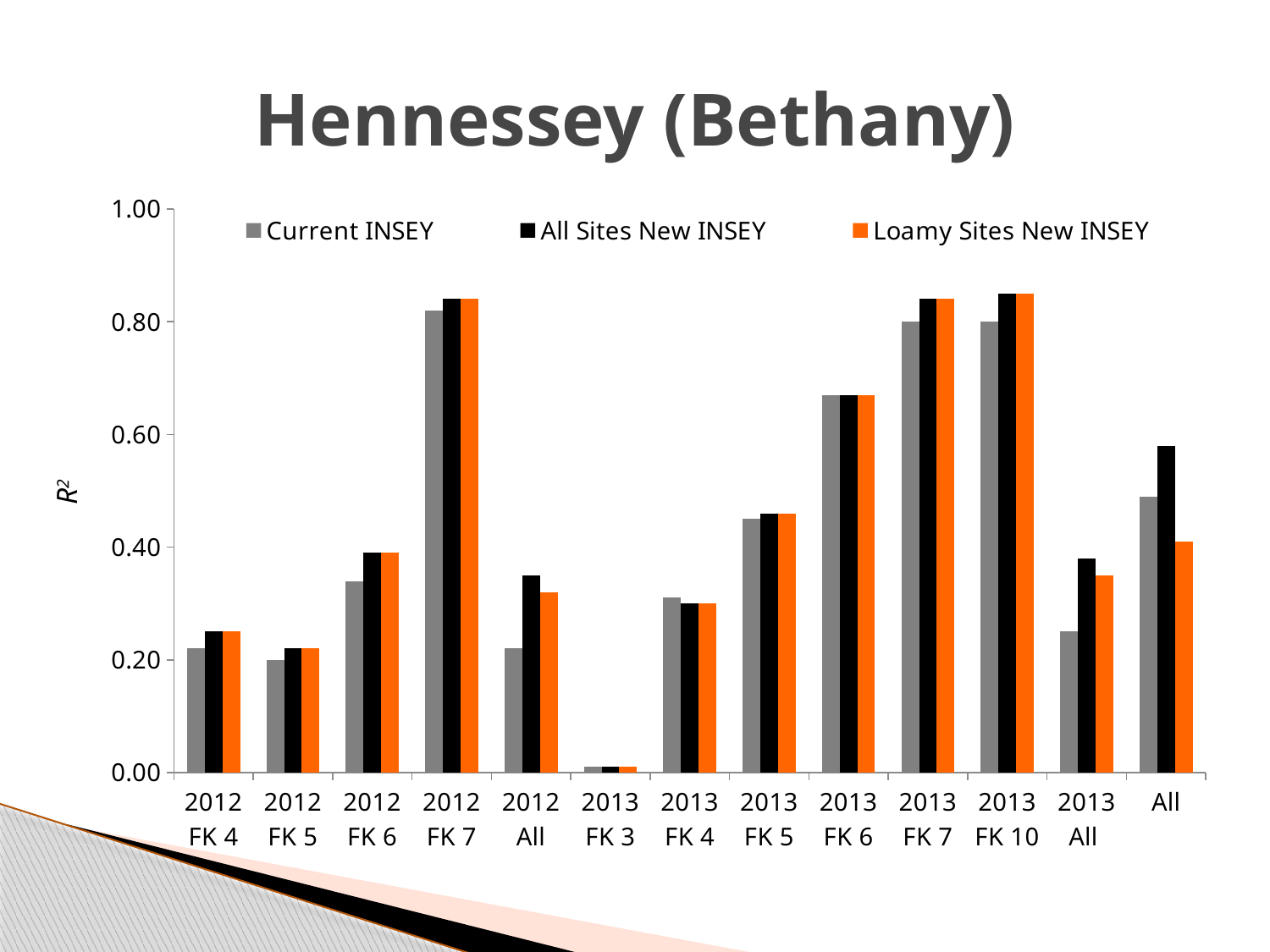
Which category has the lowest values across all three series? 2013 FK 3 Is the Current INSEY value for 2013 FK 6 greater or less than 0.60? greater Is the Current INSEY value for 2013 FK 3 greater or less than 0.20? less What is the label on the y axis? R² Is the All Sites New INSEY value for 2012 All greater or less than 0.40? less How many categories are shown along the x axis? 13 How many series does the legend list? 3 In the final 'All' category, which is larger: All Sites New INSEY or Loamy Sites New INSEY? All Sites New INSEY What is the title of the chart? Hennessey (Bethany) What kind of chart is shown on the slide? bar chart For 2013 All, which is larger: Current INSEY or All Sites New INSEY? All Sites New INSEY